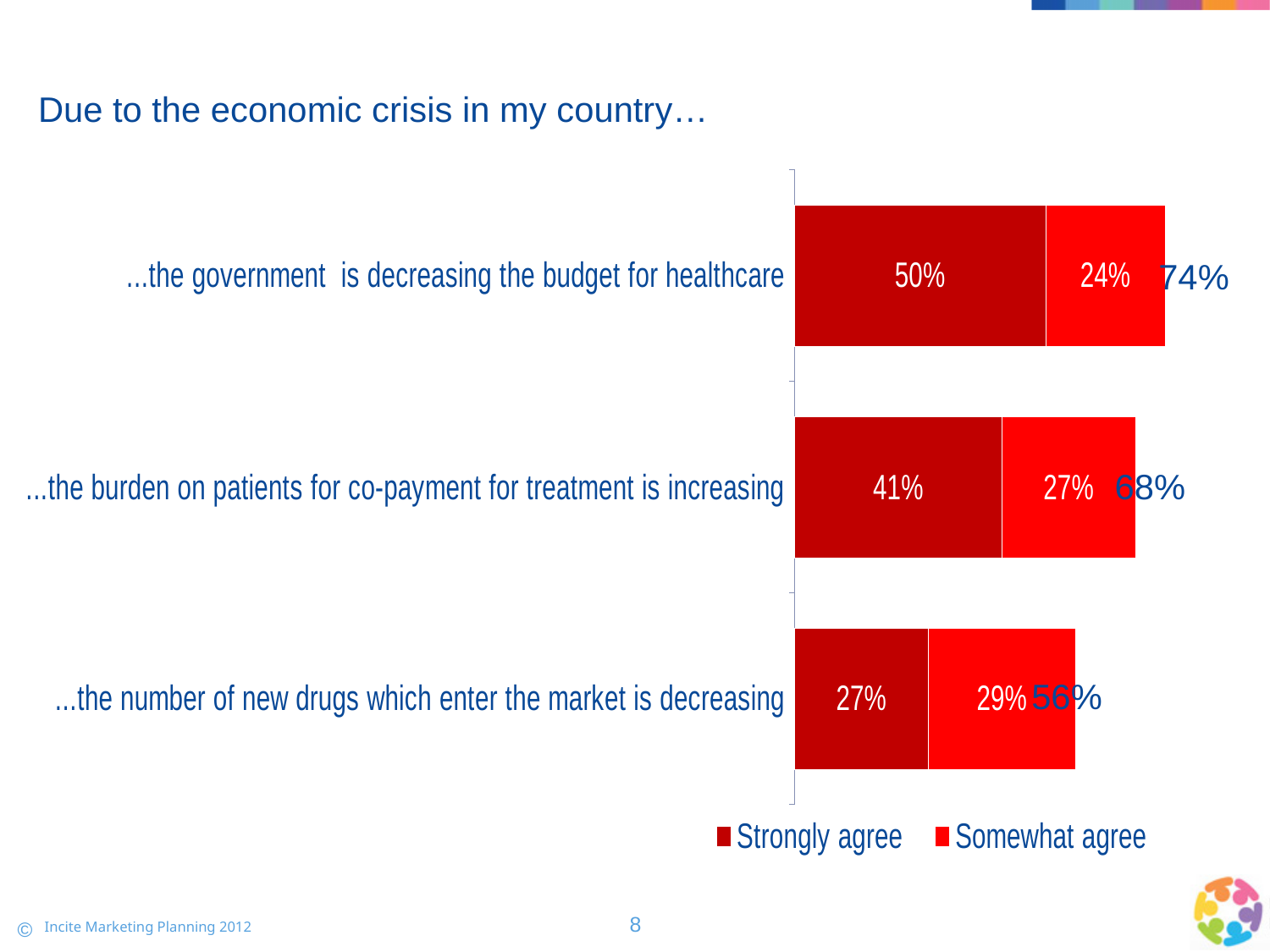
How many series does the legend list? 2 How many statements are shown in the chart? 3 What percentage somewhat agree that the burden on patients for co-payment for treatment is increasing? 27% What is the total agreement for the statement that the number of new drugs which enter the market is decreasing? 56% What kind of chart is shown on the slide? stacked bar chart What is the difference between the strongly agree percentages for the healthcare budget statement and the co-payment statement? 9% What percentage strongly agree that the number of new drugs which enter the market is decreasing? 27% Which statement has the highest share of respondents who strongly agree? ...the government is decreasing the budget for healthcare Which statement has the lowest total agreement? ...the number of new drugs which enter the market is decreasing What is the total agreement (strongly plus somewhat agree) for the statement that the government is decreasing the budget for healthcare? 74% What percentage strongly agree that the government is decreasing the budget for healthcare? 50% Which is larger: the somewhat agree share for the new drugs statement or for the healthcare budget statement? the new drugs statement (29%)